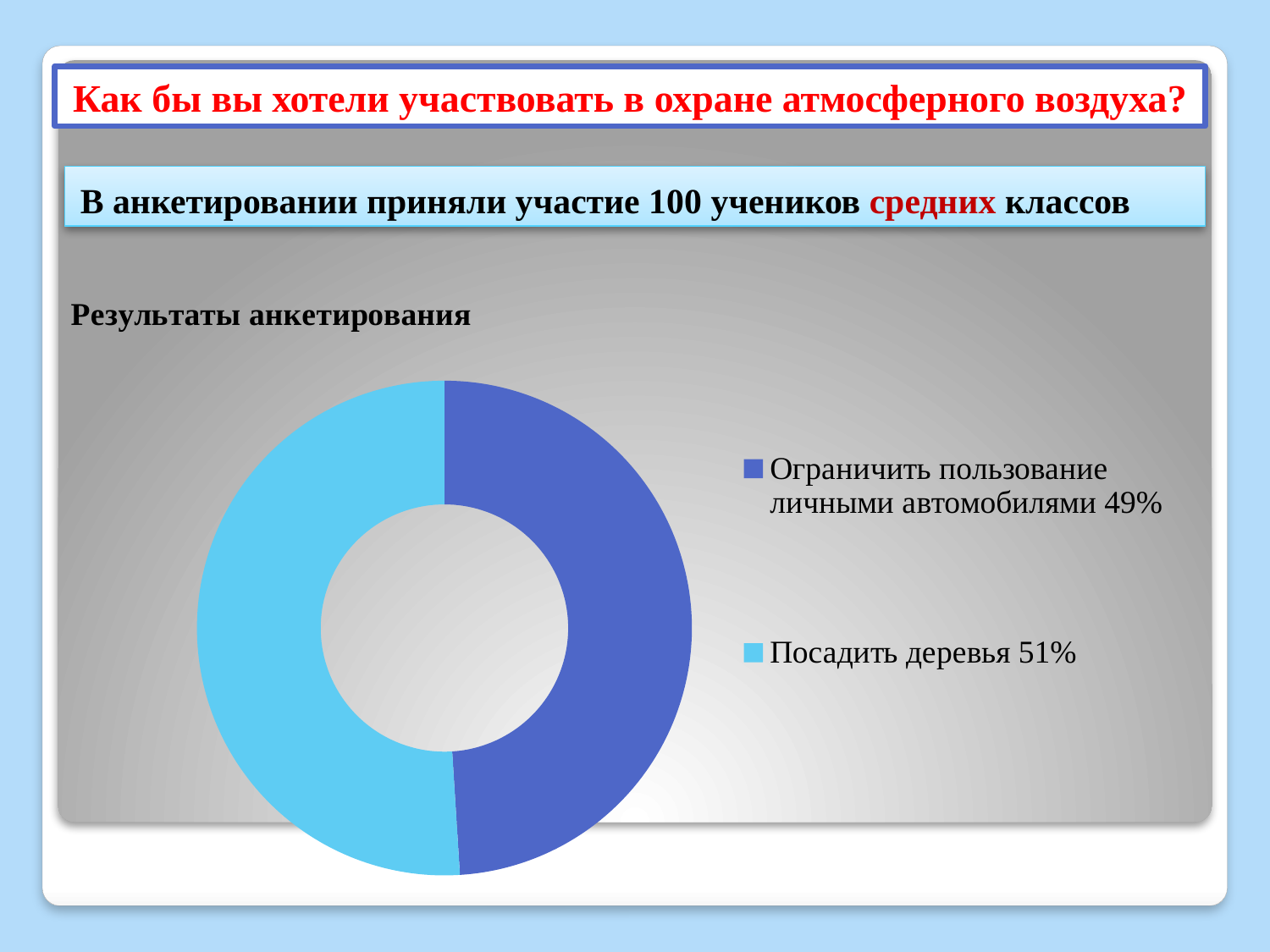
Which colour represents "Посадить деревья" in the chart? light blue What share of respondents chose "Ограничить пользование личными автомобилями"? 49% Which option received the smaller share of responses? Ограничить пользование личными автомобилями What is the title of the chart? Результаты анкетирования Is the share for "Посадить деревья" larger or smaller than the share for "Ограничить пользование личными автомобилями"? larger What share of respondents chose "Посадить деревья"? 51% Which option received the larger share of responses? Посадить деревья What do the two shares in the chart add up to? 100% What kind of chart is shown on the slide? doughnut chart By how many percentage points does "Посадить деревья" exceed "Ограничить пользование личными автомобилями"? 2 How many categories does the chart show? 2